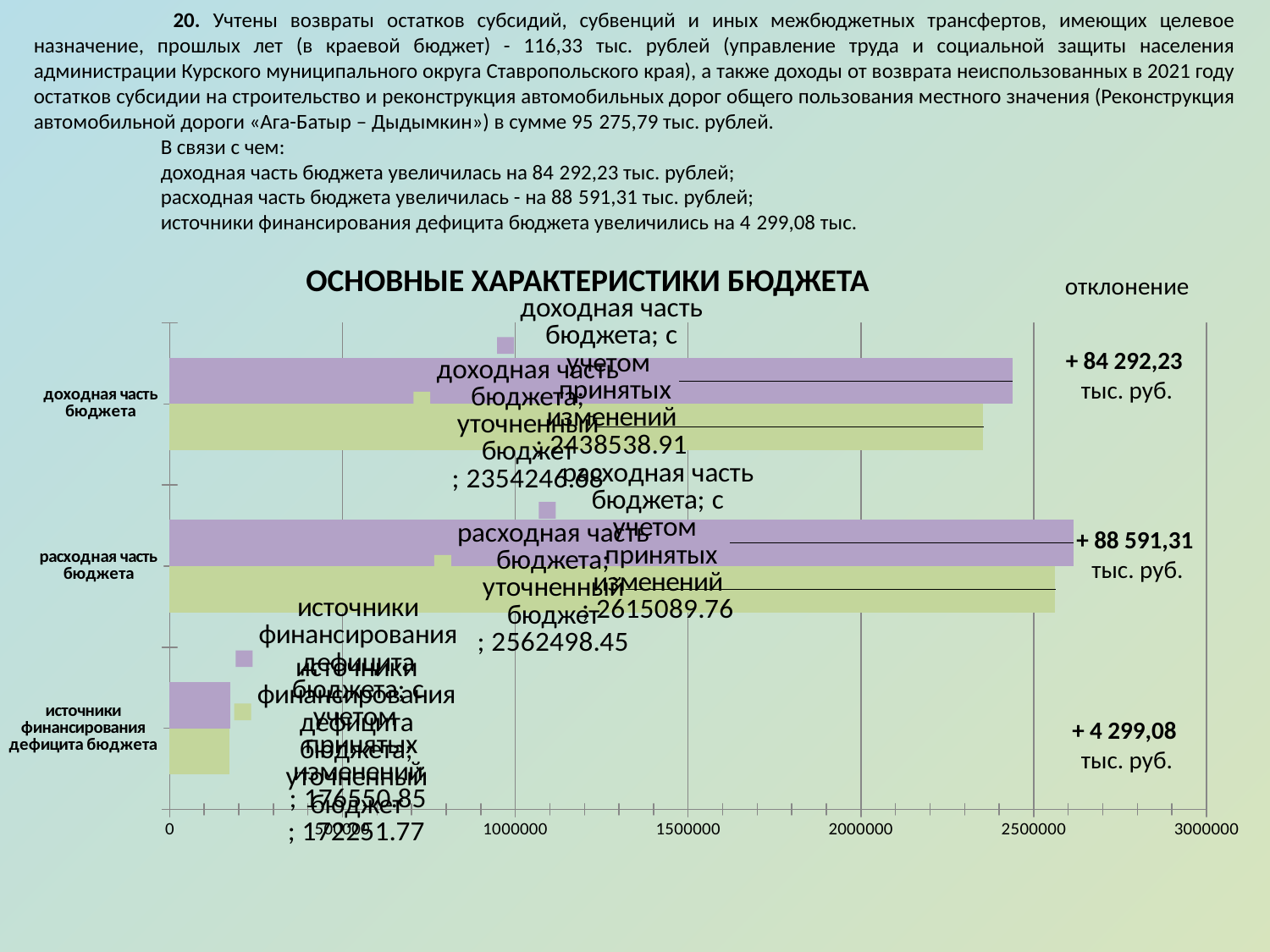
Which category has the lowest value on the chart? источники финансирования дефицита бюджета What deviation (отклонение) is shown for 'источники финансирования дефицита бюджета'? + 4 299,08 тыс. руб. What is the difference between 'расходная часть бюджета' with adopted changes (2615089.76) and in the refined budget (2562498.45)? 52591.31 What is the title of the chart? ОСНОВНЫЕ ХАРАКТЕРИСТИКИ БЮДЖЕТА What is the value of 'источники финансирования дефицита бюджета' with the adopted changes (с учетом принятых изменений)? 176550.85 Is the value for 'расходная часть бюджета' with adopted changes greater or less than 2500000? greater What is the value of 'расходная часть бюджета' in the refined budget (уточненный бюджет)? 2562498.45 Which category has the highest value on the chart? расходная часть бюджета How many categories are plotted on the chart? 3 What kind of chart is shown on the slide? bar chart What is the value of 'доходная часть бюджета' with the adopted changes (с учетом принятых изменений)? 2438538.91 Which is larger: 'доходная часть бюджета' with adopted changes or 'доходная часть бюджета' in the refined budget? доходная часть бюджета with adopted changes